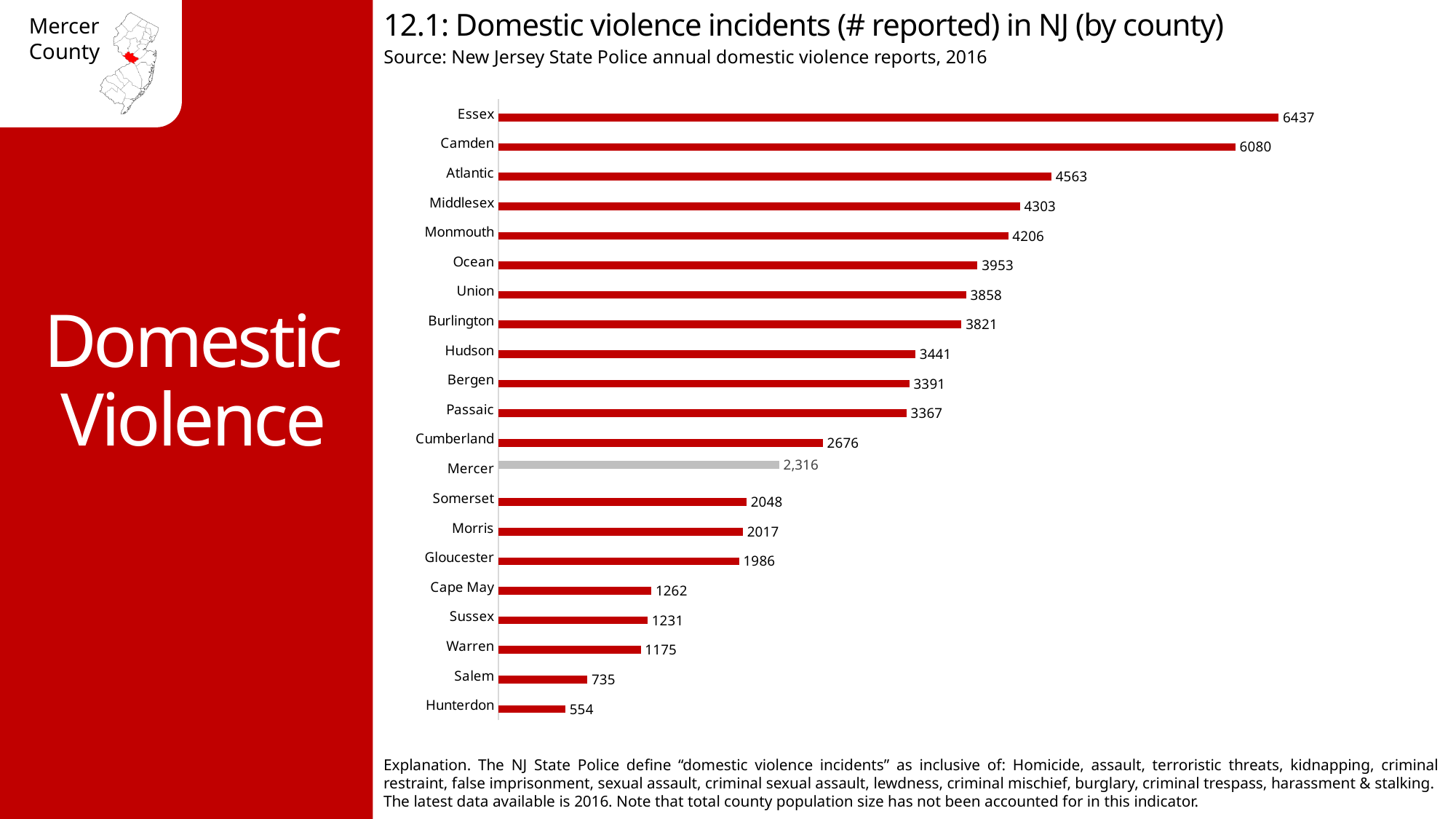
What is the number of domestic violence incidents reported for Essex County? 6437 Which county has more reported incidents, Atlantic or Middlesex? Atlantic What is the difference in reported incidents between Cumberland and Mercer? 360 What is the number of domestic violence incidents reported for Hudson County? 3441 Which county has more reported incidents, Salem or Warren? Warren How many counties are shown in the chart? 21 Which county has the highest number of reported domestic violence incidents? Essex What is the number of domestic violence incidents reported for Mercer County? 2,316 Which county has the lowest number of reported domestic violence incidents? Hunterdon Which county's bar is shown in grey rather than red? Mercer What type of chart is used on this slide? Bar chart What is the difference in reported incidents between Essex and Camden? 357